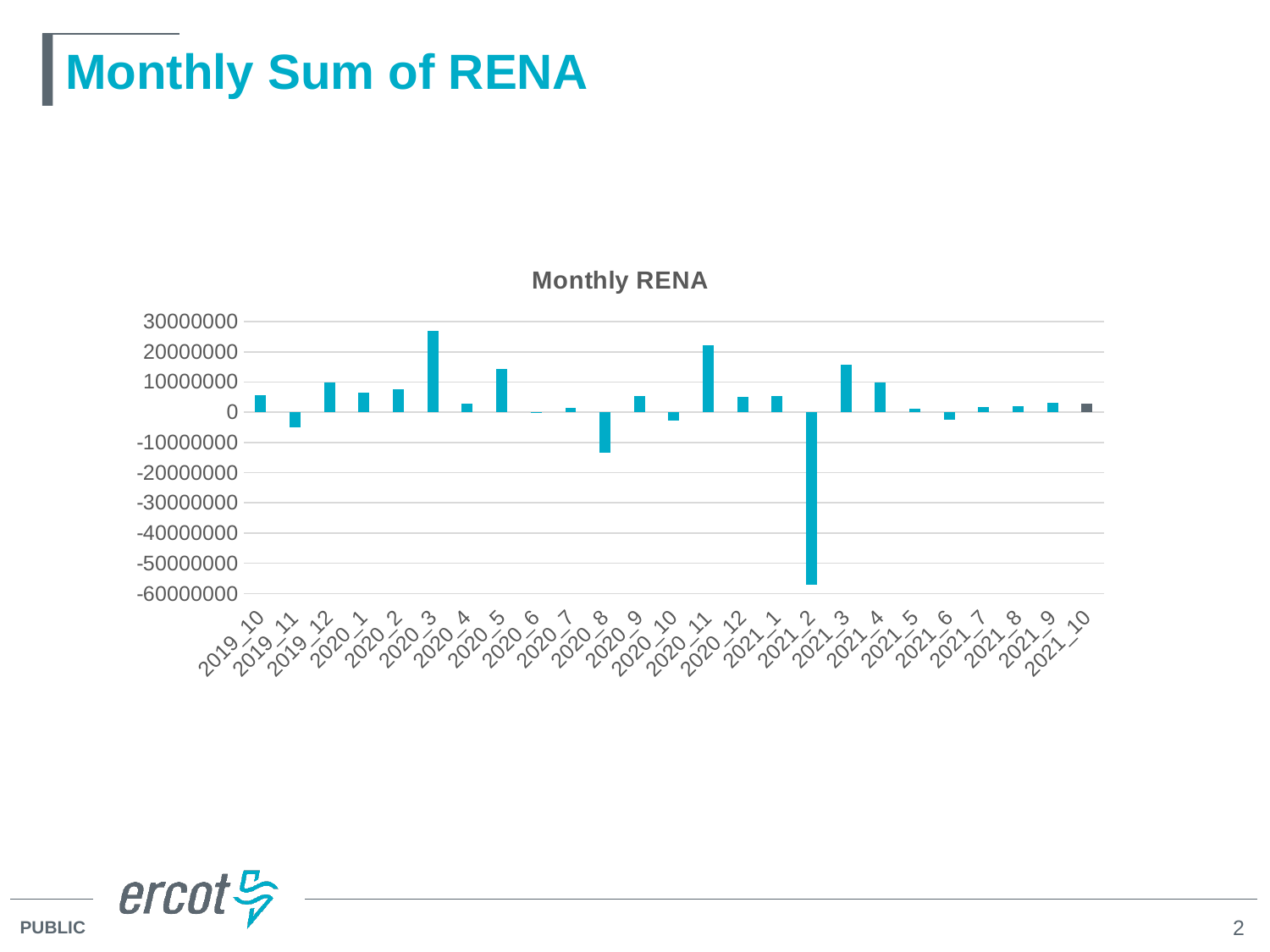
Is the value for 2021_2 greater or less than -50000000? less Which is larger, the value for 2021_3 or the value for 2021_4? 2021_3 Which month has the lowest Monthly RENA value? 2021_2 Which is larger, the value for 2020_3 or the value for 2020_11? 2020_3 Is the value for 2020_8 greater or less than -10000000? less What kind of chart is shown on the slide? bar chart How many monthly categories are plotted on the x axis? 25 Is the value for 2020_5 greater or less than 10000000? greater Which month has the highest Monthly RENA value? 2020_3 What is the title of the chart? Monthly RENA Which month's bar is shown in a different colour (dark grey) from the rest? 2021_10